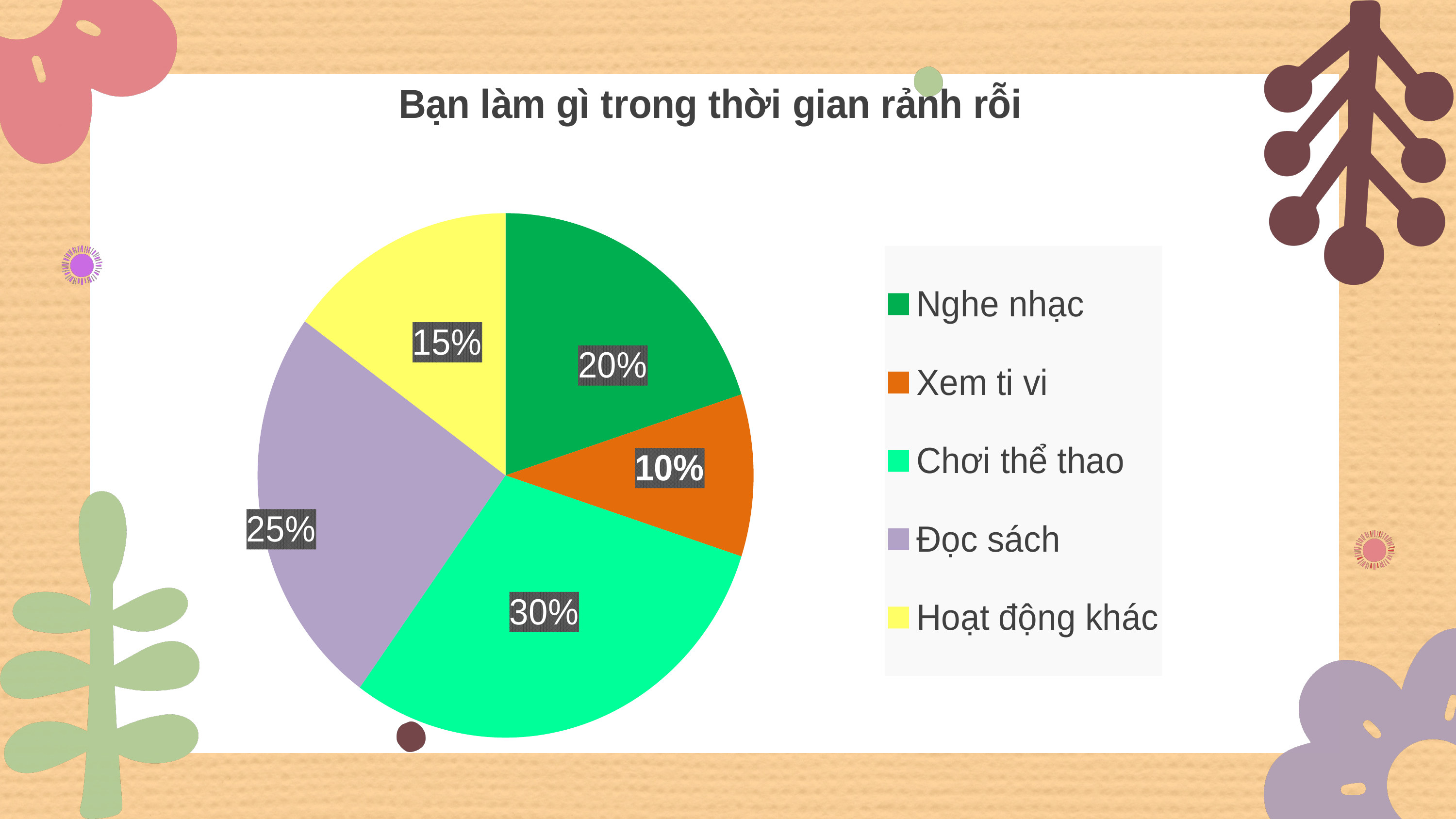
How many categories does the legend list? 5 What is the title of the chart? Bạn làm gì trong thời gian rảnh rỗi What is the difference between the shares of Chơi thể thao and Nghe nhạc? 10% Which category has the largest share of the pie? Chơi thể thao What type of chart is shown on the slide? pie chart What percentage of the pie is Xem ti vi? 10% What percentage of the pie is Hoạt động khác? 15% What percentage of the pie is Chơi thể thao? 30% What percentage of the pie is Đọc sách? 25% What percentage of the pie is Nghe nhạc? 20% Which category has the smallest share of the pie? Xem ti vi Which is larger, the share for Đọc sách or the share for Hoạt động khác? Đọc sách